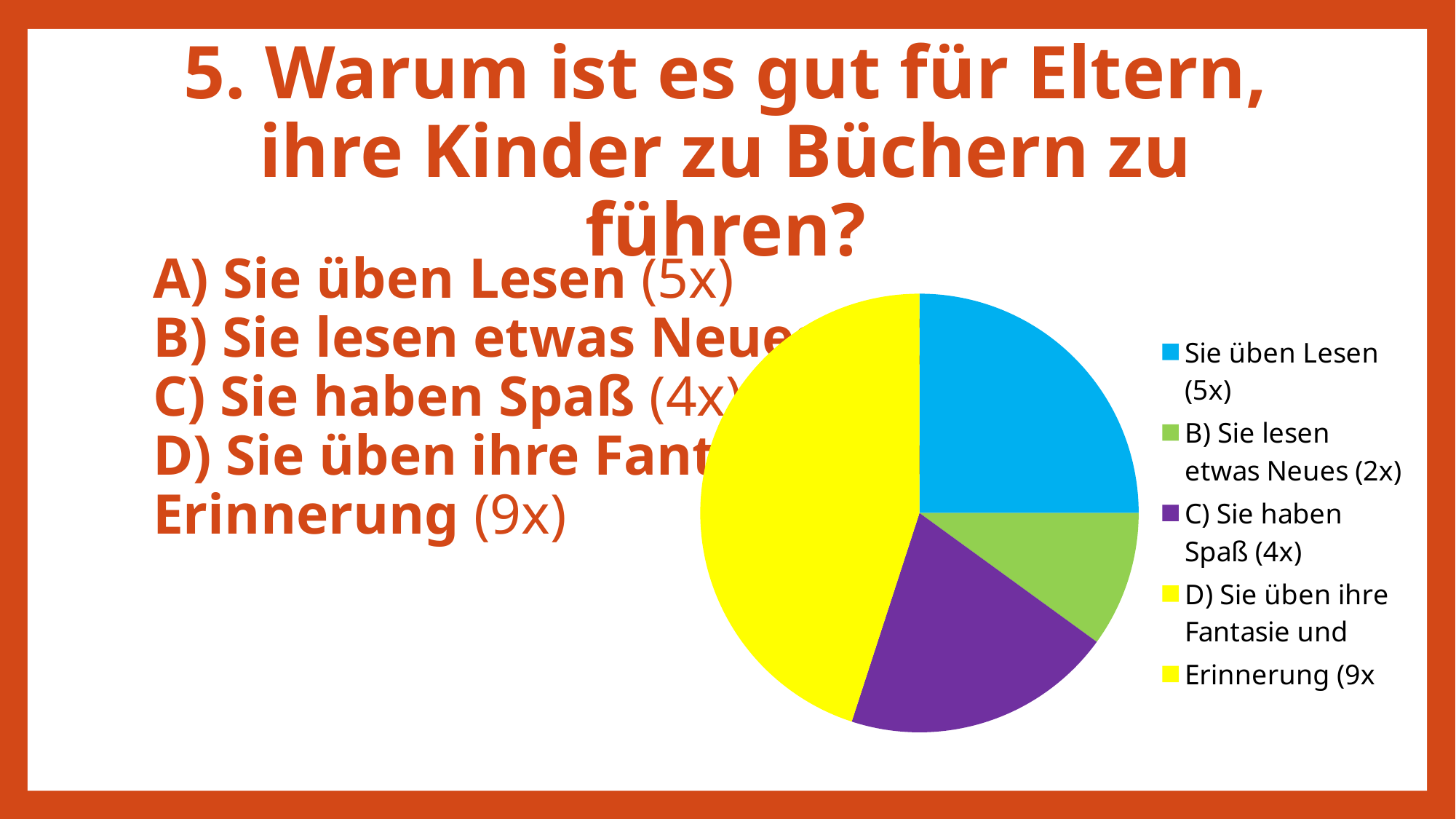
What colour is the slice for "C) Sie haben Spaß" in the pie chart? purple How many entries does the legend of the pie chart list? 5 How many times was "C) Sie haben Spaß" chosen according to the legend? 4x What share of the pie does "D) Sie üben ihre Fantasie und Erinnerung" represent? 45% How many times was "Sie üben Lesen" chosen according to the legend? 5x Which answer option has the largest slice of the pie chart? D) Sie üben ihre Fantasie und Erinnerung (9x) How many slices does the pie chart have? 4 How many times was "B) Sie lesen etwas Neues" chosen according to the legend? 2x What is the difference between the counts for "D) Sie üben ihre Fantasie und Erinnerung" and "Sie üben Lesen"? 4 Which slice is larger: "Sie üben Lesen" or "C) Sie haben Spaß"? Sie üben Lesen What kind of chart is shown on the slide? pie chart Which answer option has the smallest slice of the pie chart? B) Sie lesen etwas Neues (2x)